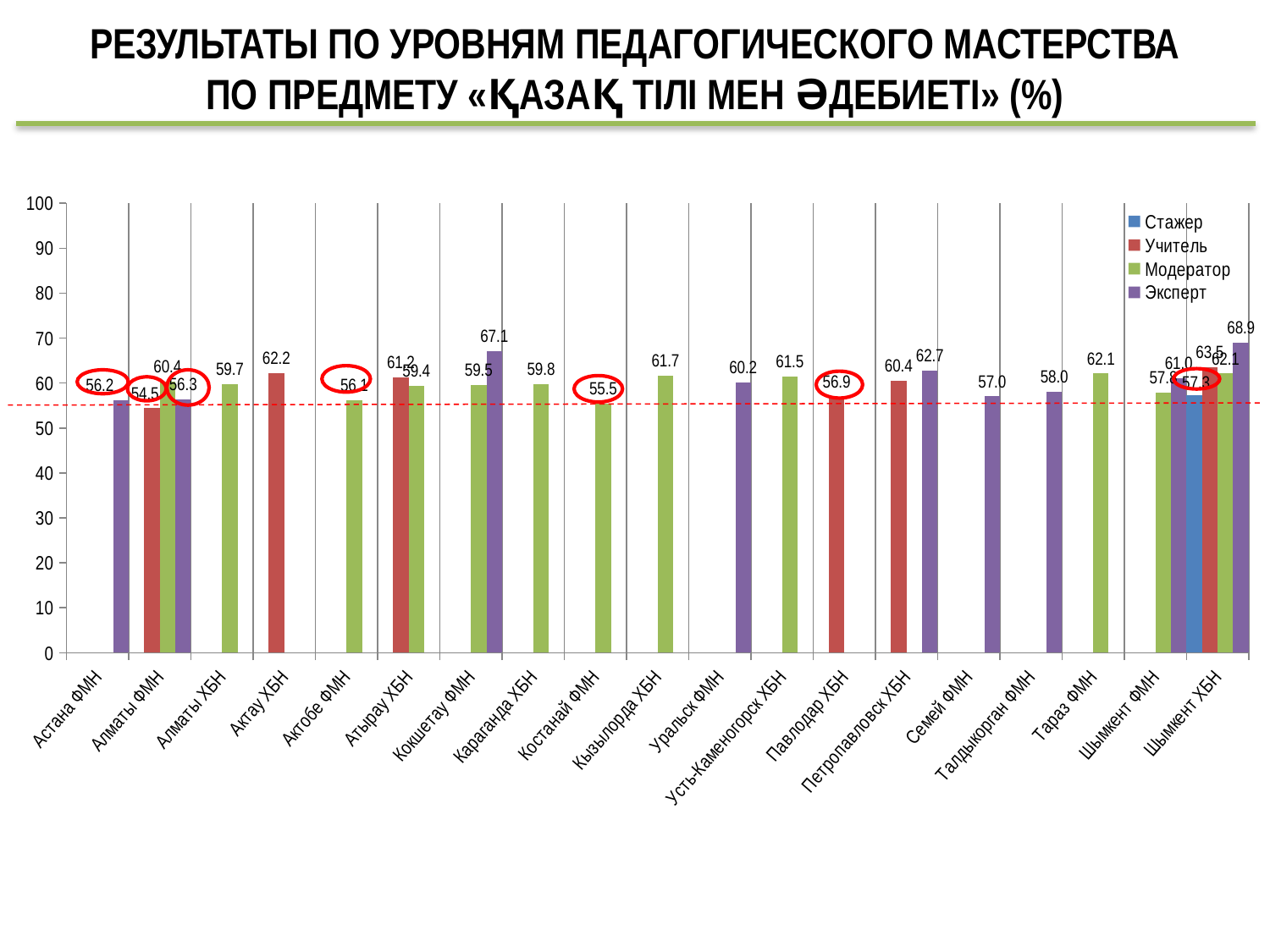
How many categories are shown on the x axis? 19 Which category has the lowest Учитель value? Алматы ФМН Which is larger in Алматы ФМН: the Модератор value or the Эксперт value? Модератор What type of chart is shown on the slide? bar chart How many series does the legend list? 4 What is the value for Учитель in Актау ХБН? 62.2 What is the value for Эксперт in Кокшетау ФМН? 67.1 What is the value for Стажер in Шымкент ХБН? 57.3 Is the value for Модератор in Костанай ФМН greater or less than 60? less What is the difference between the Эксперт and Учитель values in Петропавловск ХБН? 2.3 Which category has the highest Эксперт value? Шымкент ХБН Which legend entry is shown in blue? Стажер